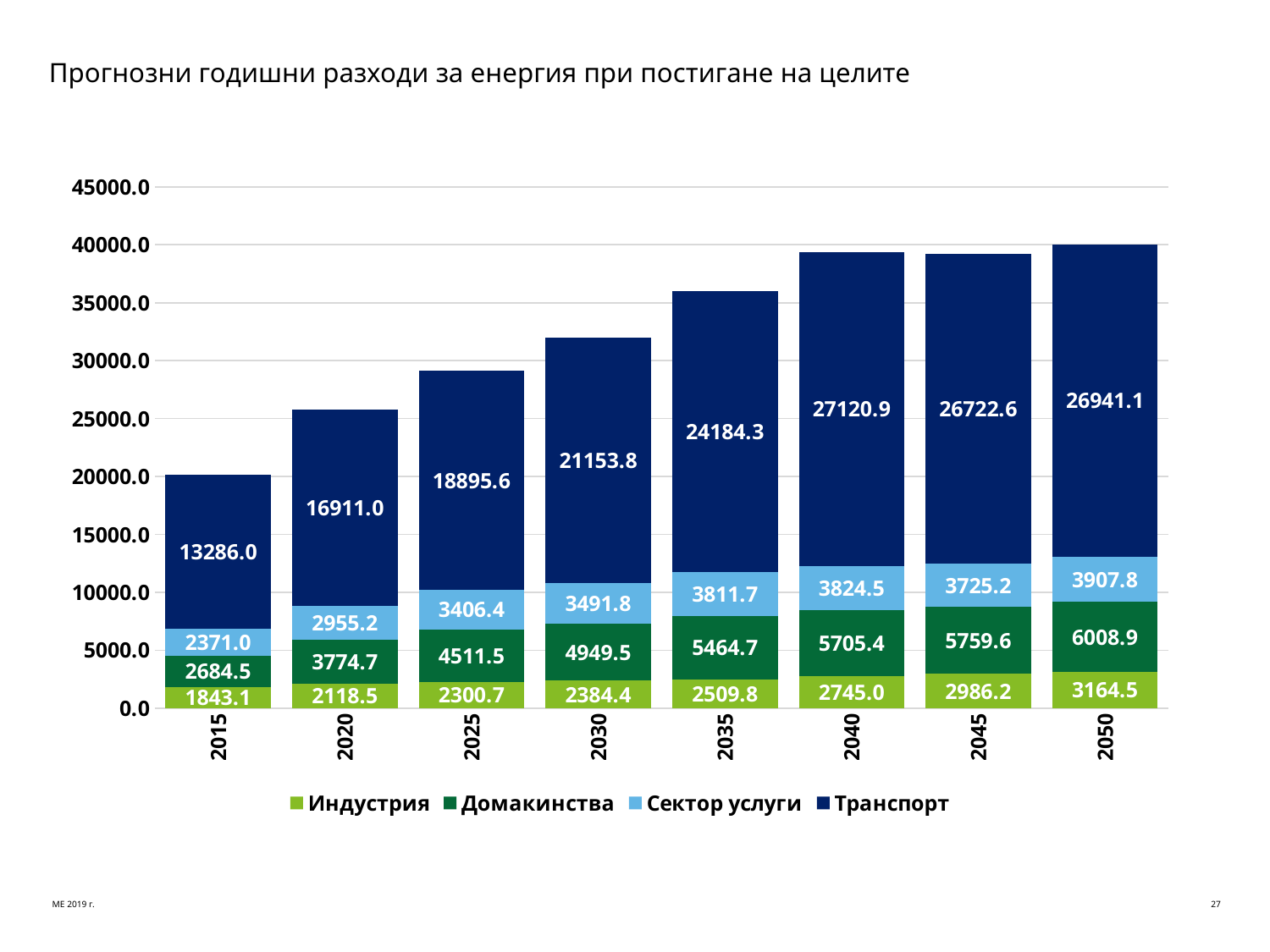
How many years are shown on the x axis? 8 What is the total of the stacked bar for 2015? 20184.6 Which is larger in 2030: Домакинства or Сектор услуги? Домакинства What is the value for Сектор услуги in 2025? 3406.4 In which year is the Транспорт value highest? 2040 In which year is the Индустрия value lowest? 2015 What is the difference between the Транспорт values for 2050 and 2015? 13655.1 What kind of chart is shown on the slide? Stacked bar chart What is the value for Транспорт in 2015? 13286.0 Is the total stacked value for 2030 greater or less than 30000.0? greater How many series does the legend list? 4 What is the value for Домакинства in 2040? 5705.4